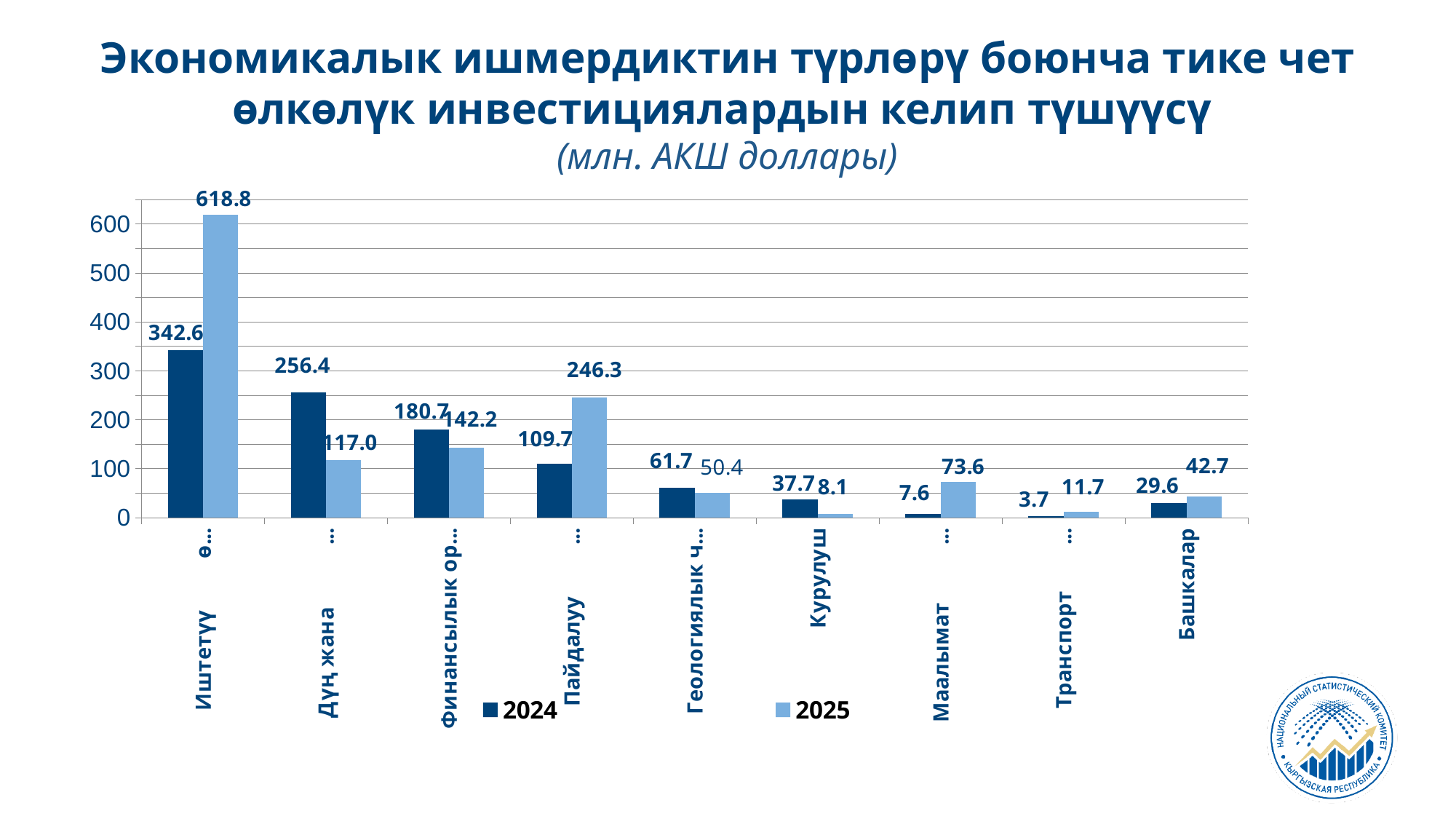
What is the 2025 value for the category labelled Маалымат? 73.6 What is the difference between the 2025 and 2024 values for the category labelled Пайдалуу? 136.6 What is the 2024 value for the category labelled Транспорт? 3.7 What kind of chart is shown on the slide? bar chart Which category has the highest 2025 value? Иштетүү For Курулуш, which is larger: the 2024 value or the 2025 value? 2024 What is the 2025 value for Курулуш? 8.1 Is the 2025 value for the category labelled Иштетүү greater or less than 600? greater What is the 2024 value for Башкалар? 29.6 How many series does the legend list? 2 How many categories are shown on the x axis? 9 Which category has the lowest 2024 value? Транспорт